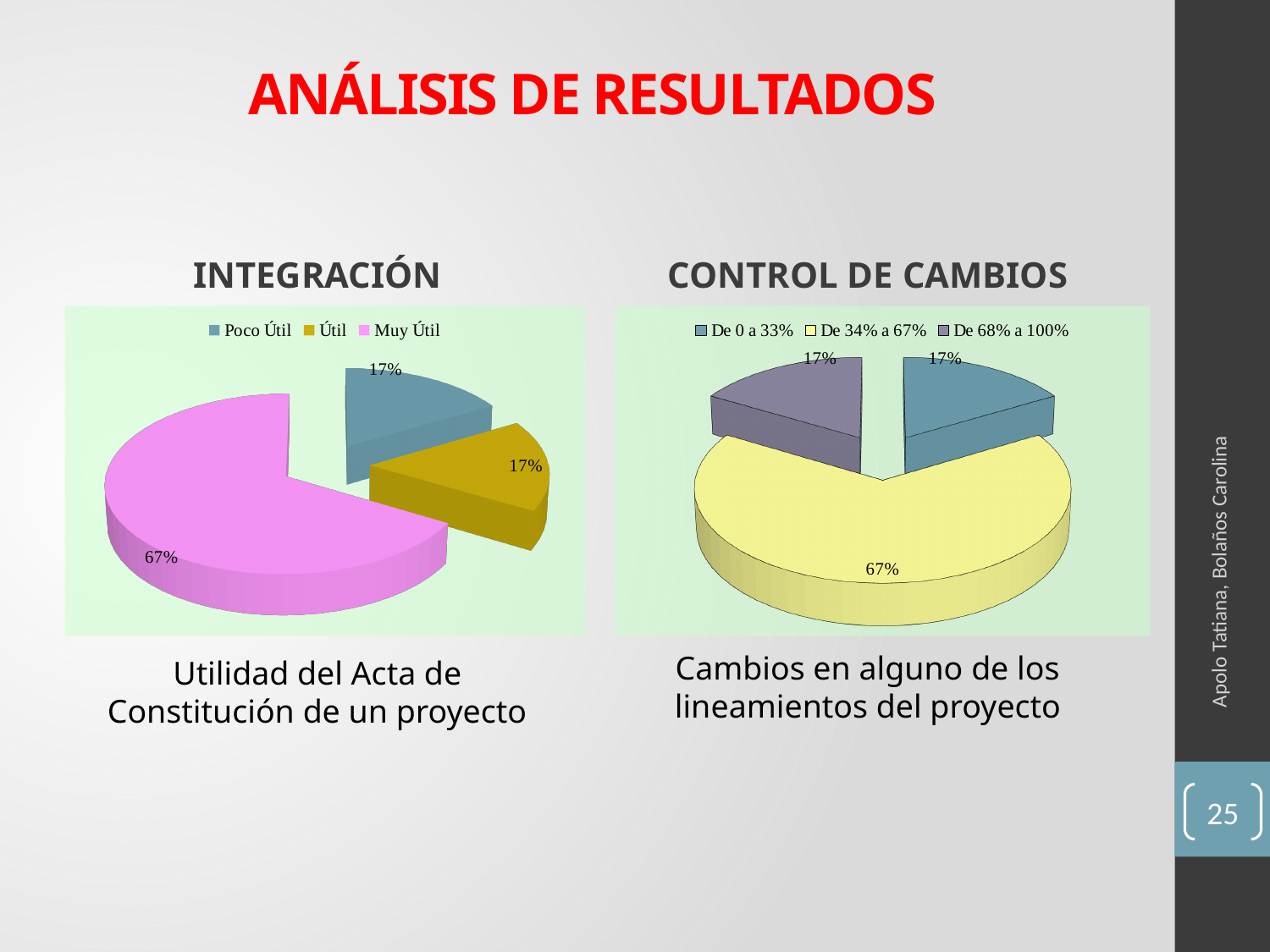
In the CONTROL DE CAMBIOS chart, what is the difference between the De 34% a 67% share and the De 0 a 33% share? 50% In the CONTROL DE CAMBIOS chart, which category has the largest slice? De 34% a 67% In the INTEGRACIÓN chart, what colour is the Muy Útil slice? Pink How many categories does the legend of the INTEGRACIÓN chart list? 3 In the INTEGRACIÓN chart, which category has the largest slice? Muy Útil In the INTEGRACIÓN chart, what is the difference between the Muy Útil share and the Útil share? 50% In the INTEGRACIÓN chart, what share of the pie is Muy Útil? 67% In the CONTROL DE CAMBIOS chart, what share of the pie is De 34% a 67%? 67% In the INTEGRACIÓN chart, which is larger, Muy Útil or Poco Útil? Muy Útil In the INTEGRACIÓN chart, what share of the pie is Poco Útil? 17% What kind of chart is the INTEGRACIÓN chart? Pie chart